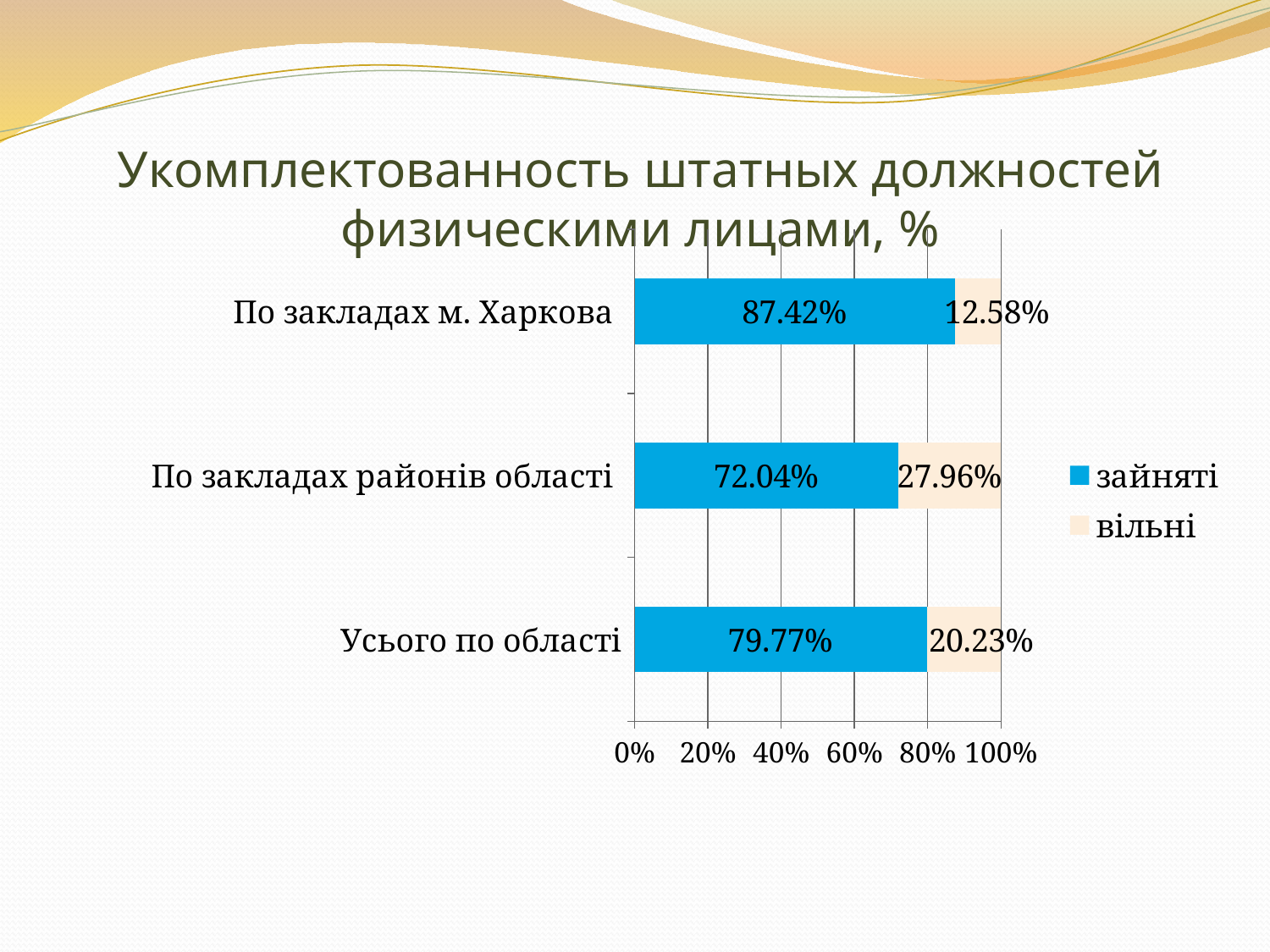
How many categories are shown on the chart? 3 What is the value of зайняті for По закладах м. Харкова? 87.42% How many series does the legend list? 2 What is the value of вільні for По закладах районів області? 27.96% Which category has the lowest зайняті value? По закладах районів області What is the value of вільні for Усього по області? 20.23% What is the value of зайняті for Усього по області? 79.77% Which category has the highest зайняті value? По закладах м. Харкова Which is larger: the вільні value for По закладах м. Харкова or for Усього по області? Усього по області What kind of chart is shown on the slide? Stacked bar chart What is the total of the stacked bar for По закладах районів області? 100% What is the difference between the зайняті values for По закладах м. Харкова and По закладах районів області? 15.38%